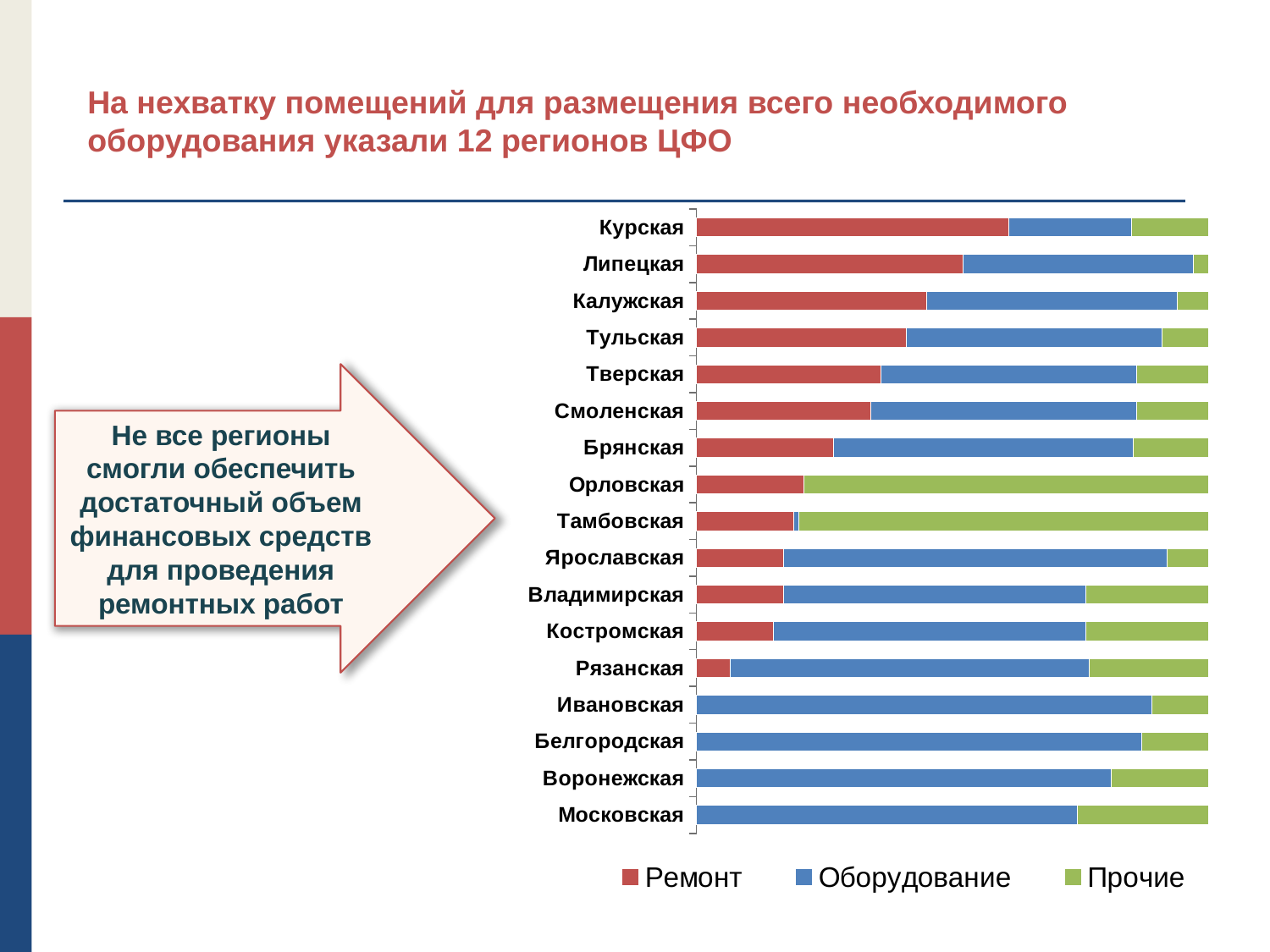
Which region has the smallest non-zero Ремонт segment? Рязанская Which region has the smallest Прочие segment? Липецкая How many regions have no Ремонт segment? 4 Which region has the larger Ремонт segment, Курская or Липецкая? Курская Which region has no Оборудование segment at all? Орловская How many series does the legend list? 3 Which region has the largest Ремонт segment? Курская Which colour represents the Ремонт series? Red What are the three series named in the legend? Ремонт, Оборудование, Прочие What kind of chart is shown on the slide? Stacked horizontal bar chart How many regions are listed on the chart? 17 Which region has the larger Оборудование segment, Московская or Воронежская? Воронежская